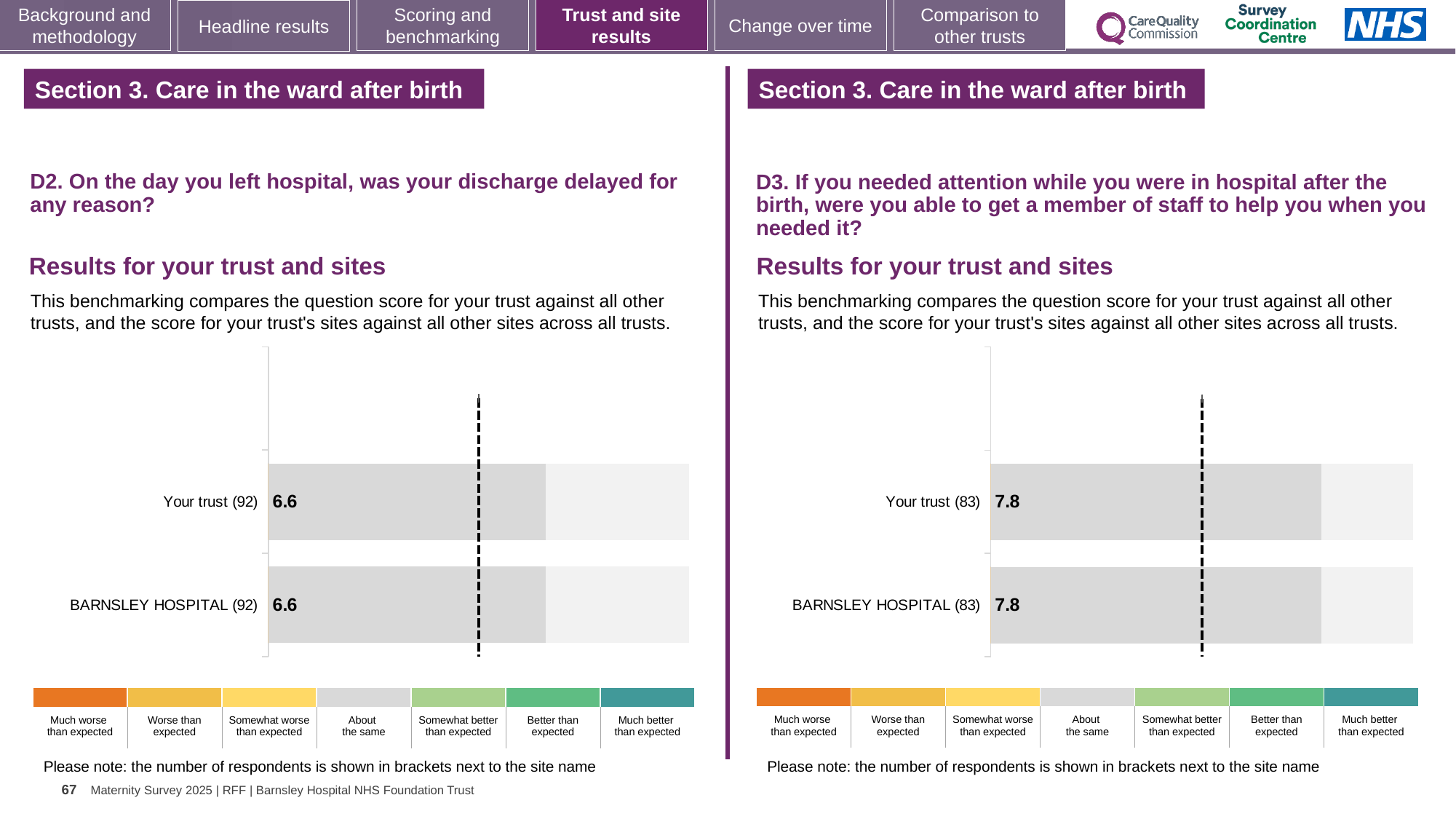
Is the Your trust score on the left chart (D2) larger or smaller than the Your trust score on the right chart (D3)? Smaller On the right chart (D3), which benchmark category does the grey colour of the bars correspond to in the legend? About the same On the right chart (D3), how many categories are shown? 2 On the left chart (D2), what is the difference between the Your trust score and the BARNSLEY HOSPITAL score? 0 On the left chart (D2), how many respondents are shown in brackets next to Your trust? 92 On the right chart (D3), what is the score for Your trust? 7.8 On the right chart (D3), is the score for BARNSLEY HOSPITAL greater or less than the score for Your trust, or are they equal? Equal On the right chart (D3), what is the score for BARNSLEY HOSPITAL? 7.8 On the left chart (D2), what is the score for Your trust? 6.6 What kind of chart is used on the left (D2) side of the slide? Bar chart On the left chart (D2), how many bars are plotted? 2 On the left chart (D2), what is the score for BARNSLEY HOSPITAL? 6.6